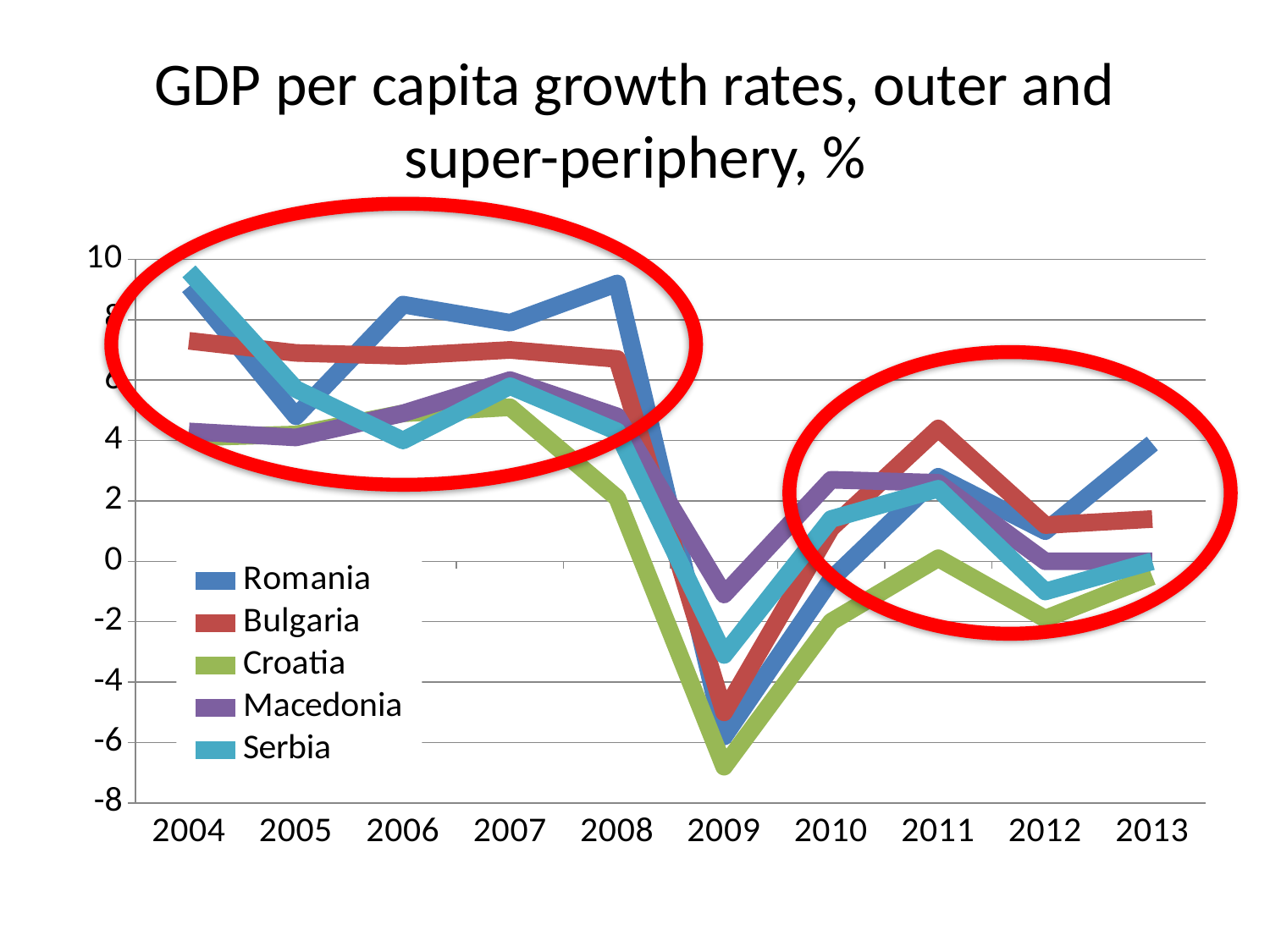
How many series does the legend list? 5 How many years are shown on the x axis? 10 What is the title of the chart? GDP per capita growth rates, outer and super-periphery, % In 2011, which is larger, the value for Bulgaria or the value for Croatia? Bulgaria Is the value for Romania in 2008 greater or less than 8? greater Between 2007 and 2009, does the value for Croatia rise or fall? fall Which country has the lowest value in 2009? Croatia Is the value for Croatia in 2009 greater or less than -6? less Which country has the highest value in 2011? Bulgaria Is the value for Macedonia in 2009 greater or less than -2? greater Which country has the highest value in 2008? Romania What kind of chart is shown on the slide? line chart